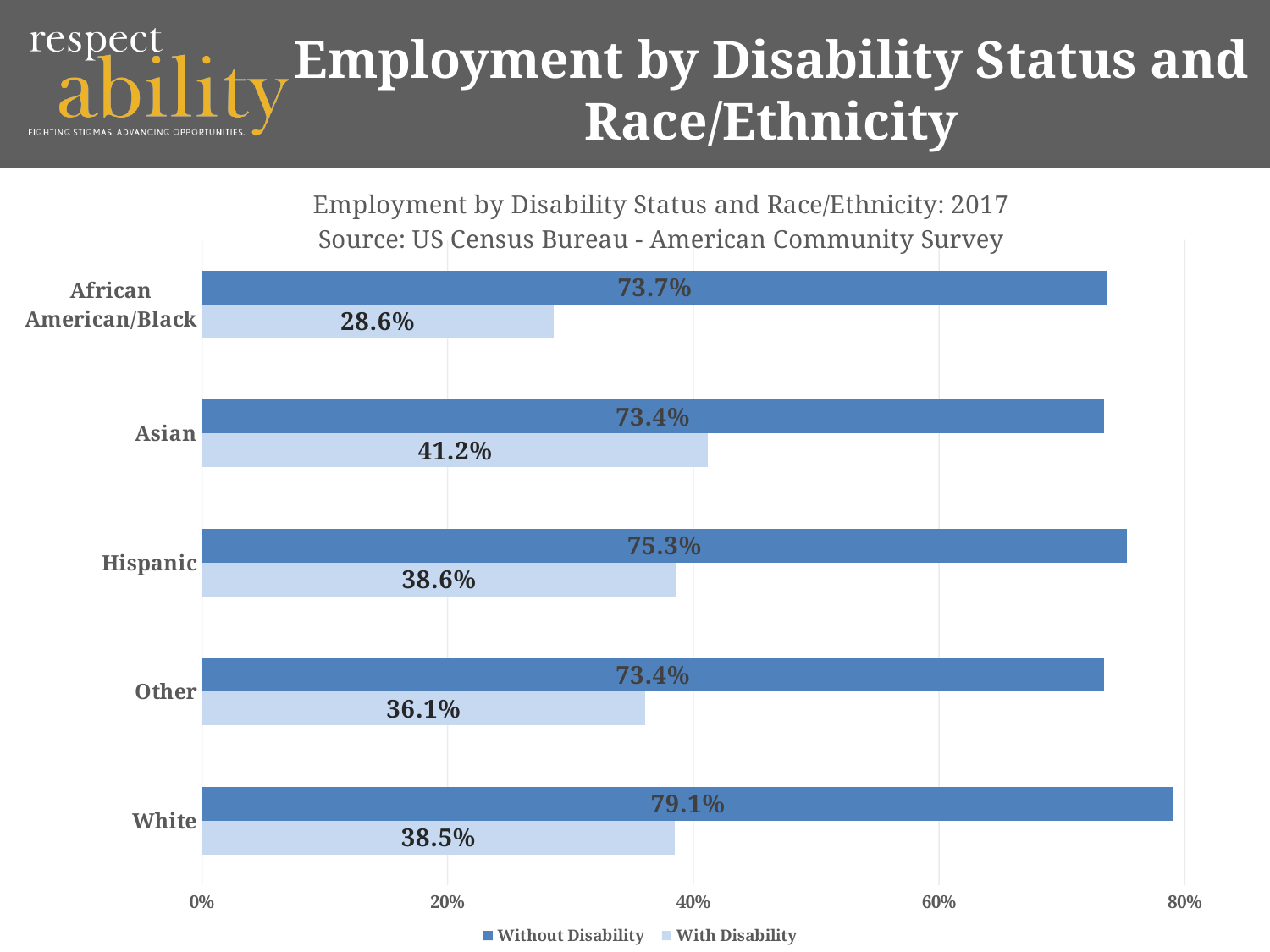
Which race/ethnicity group has the lowest employment rate with a disability? African American/Black How many series does the legend list? 2 What is the employment rate for African American/Black people with a disability? 28.6% Is the employment rate for Other people with a disability greater or less than 40%? less What is the employment rate for White people without a disability? 79.1% Which is larger: the employment rate with a disability for Asian people or for Other? Asian Which race/ethnicity group has the highest employment rate without a disability? White What is the employment rate for Asian people with a disability? 41.2% What is the difference between the employment rates of Hispanic people without a disability and with a disability? 36.7% What source is cited in the chart title? US Census Bureau - American Community Survey How many race/ethnicity categories are shown in the chart? 5 What kind of chart is shown on the slide? Bar chart